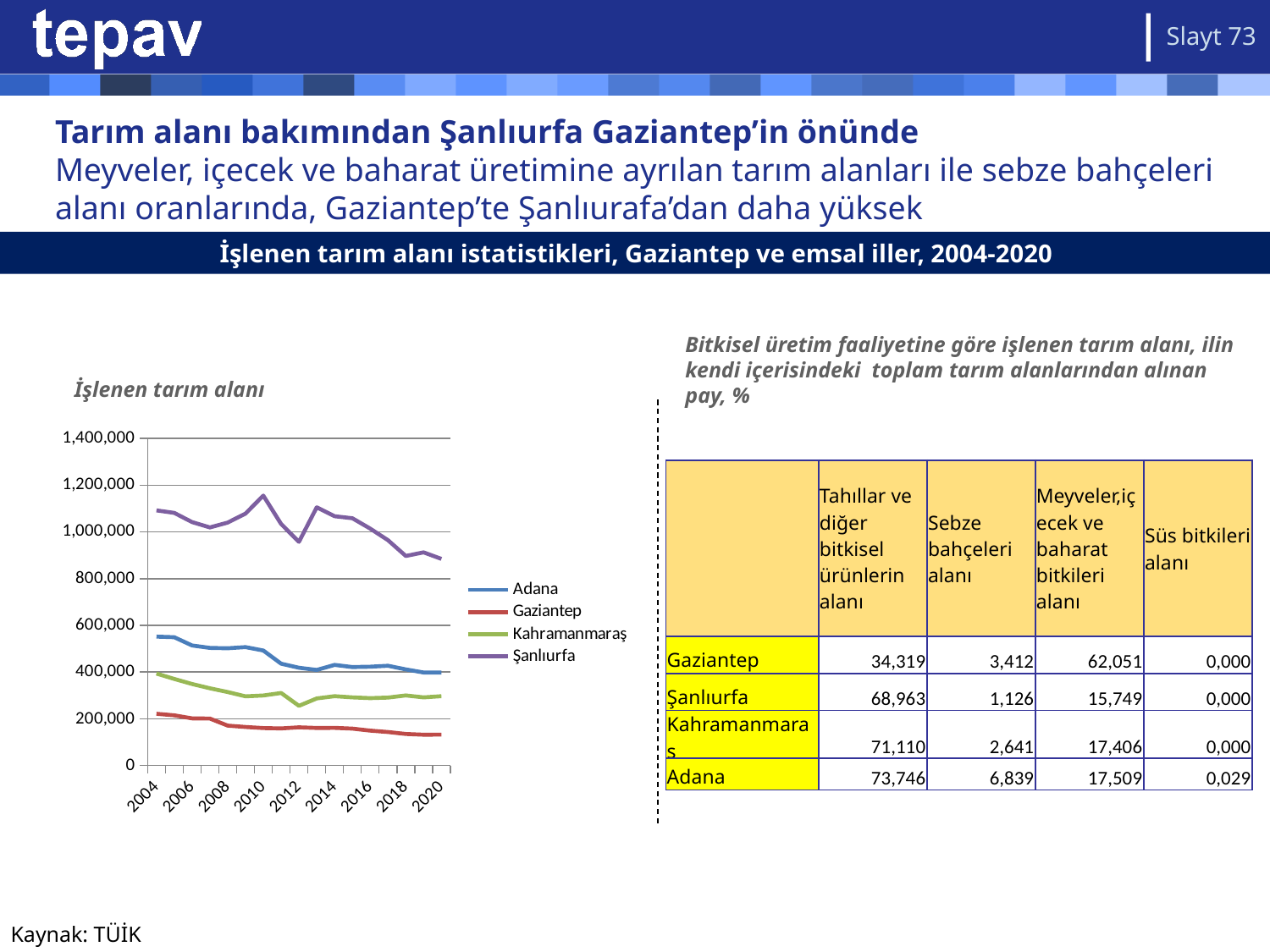
In the 'İşlenen tarım alanı' chart, is the value for Şanlıurfa in 2004 greater or less than 1,000,000? greater In the 'İşlenen tarım alanı' chart, is the value for Adana in 2004 greater or less than 400,000? greater What kind of chart is the 'İşlenen tarım alanı' chart? line chart How many series does the legend of the 'İşlenen tarım alanı' chart list? 4 In the 'İşlenen tarım alanı' chart, which is larger in 2010: Adana or Kahramanmaraş? Adana In the 'İşlenen tarım alanı' chart, is the value for Gaziantep in 2020 greater or less than 200,000? less Which series has the highest values throughout the 'İşlenen tarım alanı' chart? Şanlıurfa What is the first year shown on the x axis of the 'İşlenen tarım alanı' chart? 2004 Which series has the lowest values throughout the 'İşlenen tarım alanı' chart? Gaziantep Does the Gaziantep line in the 'İşlenen tarım alanı' chart generally rise or fall from 2004 to 2020? fall